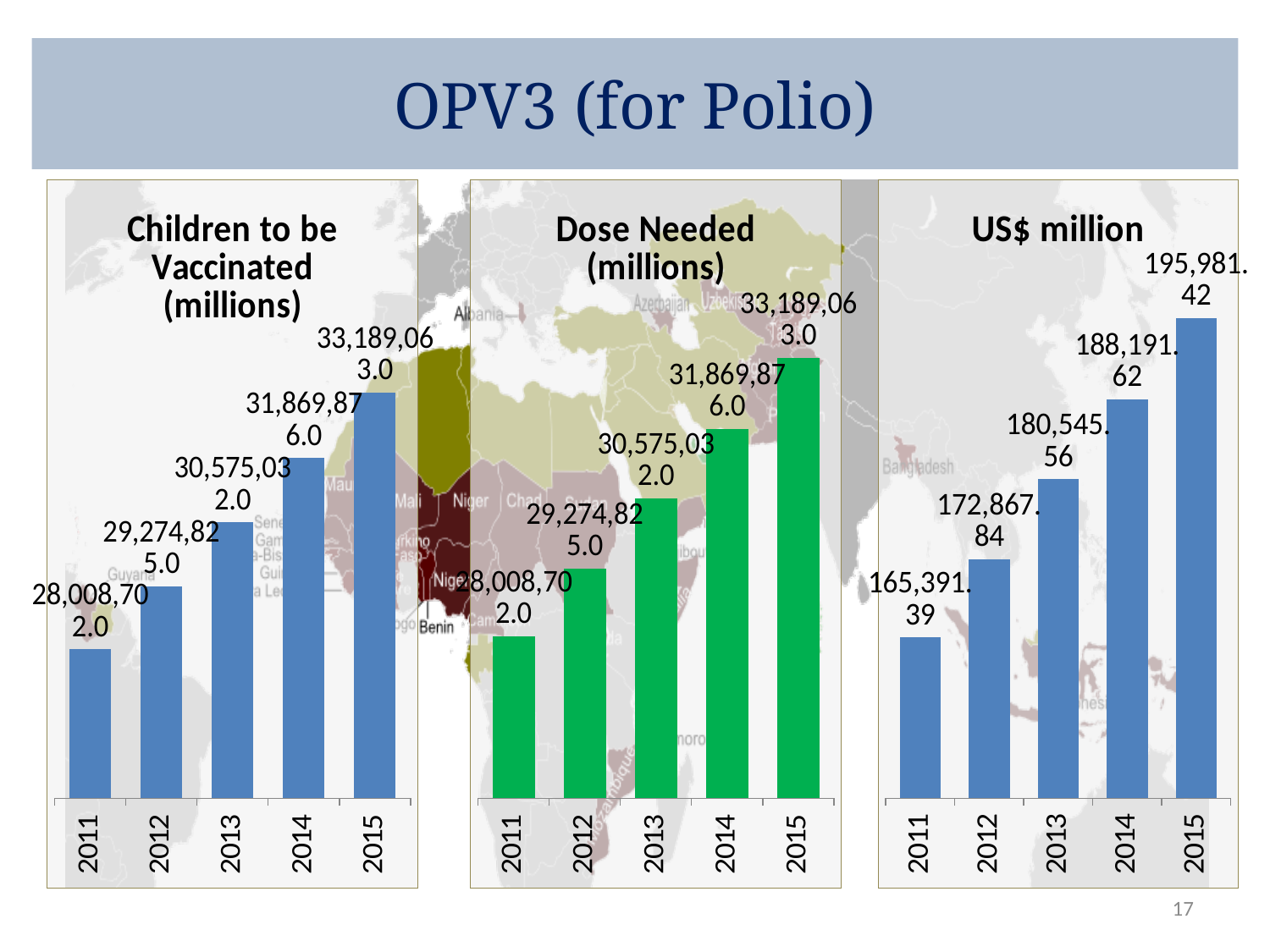
In the 'US$ million' chart, do the values rise or fall from 2011 to 2015? Rise In the 'US$ million' chart, what is the value for 2015? 195,981.42 How many bar charts are on the slide? 3 In the 'Dose Needed (millions)' chart, which is larger, the value for 2012 or the value for 2014? 2014 In the 'US$ million' chart, which year has the highest value? 2015 In the 'Children to be Vaccinated (millions)' chart, how many years are shown on the x axis? 5 In the 'Children to be Vaccinated (millions)' chart, which year has the lowest value? 2011 In the 'US$ million' chart, what is the value for 2013? 180,545.56 What colour are the bars in the 'Dose Needed (millions)' chart? Green What kind of chart is the 'Dose Needed (millions)' chart? Bar chart In the 'Dose Needed (millions)' chart, which year has the highest value? 2015 In the 'US$ million' chart, what is the value for 2011? 165,391.39